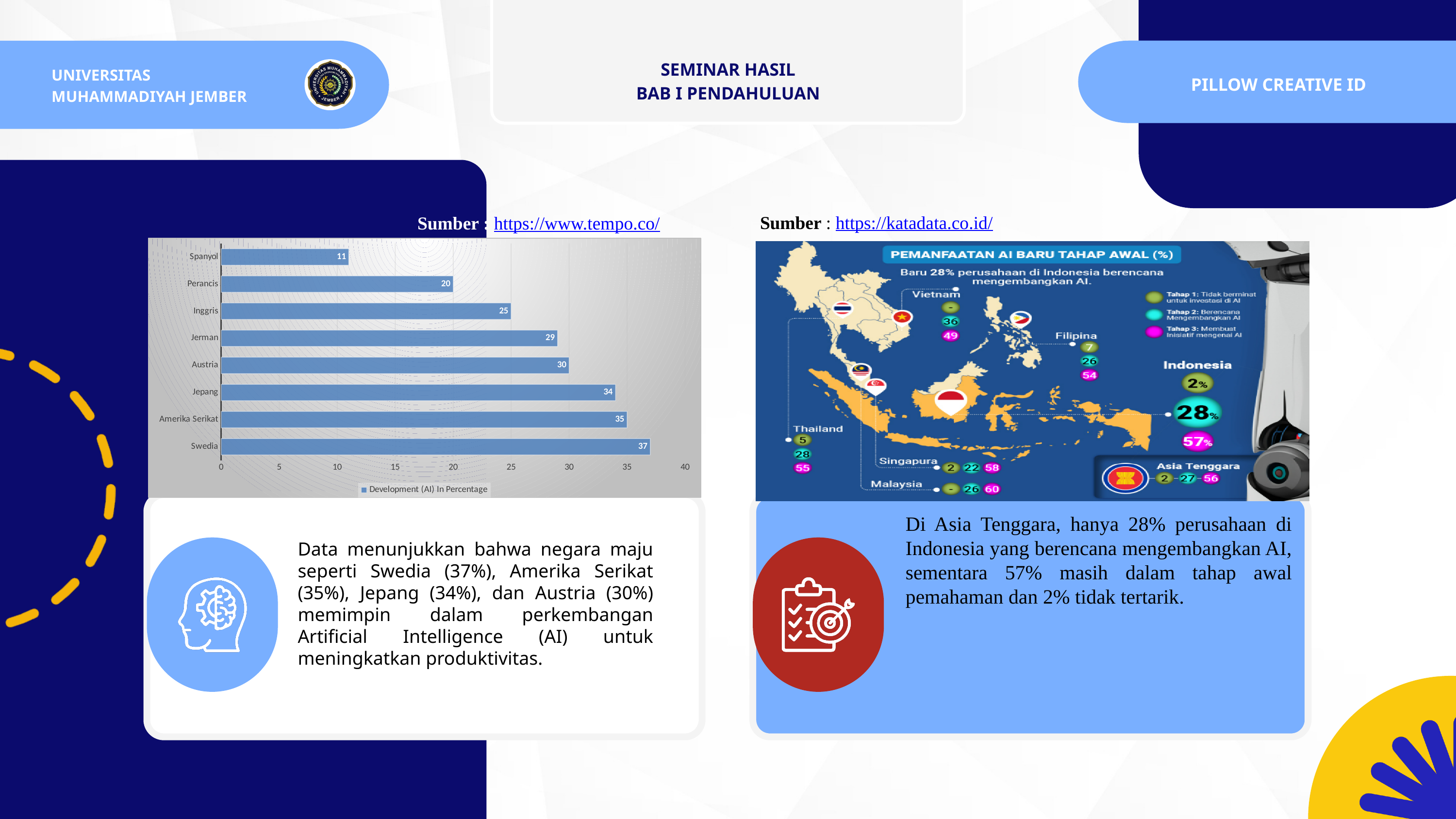
In the bar chart on the left, what is the difference between the values for Swedia and Spanyol? 26 In the bar chart on the left, how many series does the legend list? 1 In the bar chart on the left, which is larger, the value for Inggris or the value for Perancis? Inggris What kind of chart is shown on the left of the slide? Bar chart In the bar chart on the left, what is the legend entry? Development (AI) In Percentage In the bar chart on the left, which country has the lowest value? Spanyol In the bar chart on the left, what is the value for Swedia? 37 In the bar chart on the left, what is the difference between the values for Amerika Serikat and Jepang? 1 In the bar chart on the left, how many countries are shown? 8 In the bar chart on the left, which country has the highest value? Swedia In the bar chart on the left, what is the value for Jerman? 29 In the bar chart on the left, what is the value for Spanyol? 11